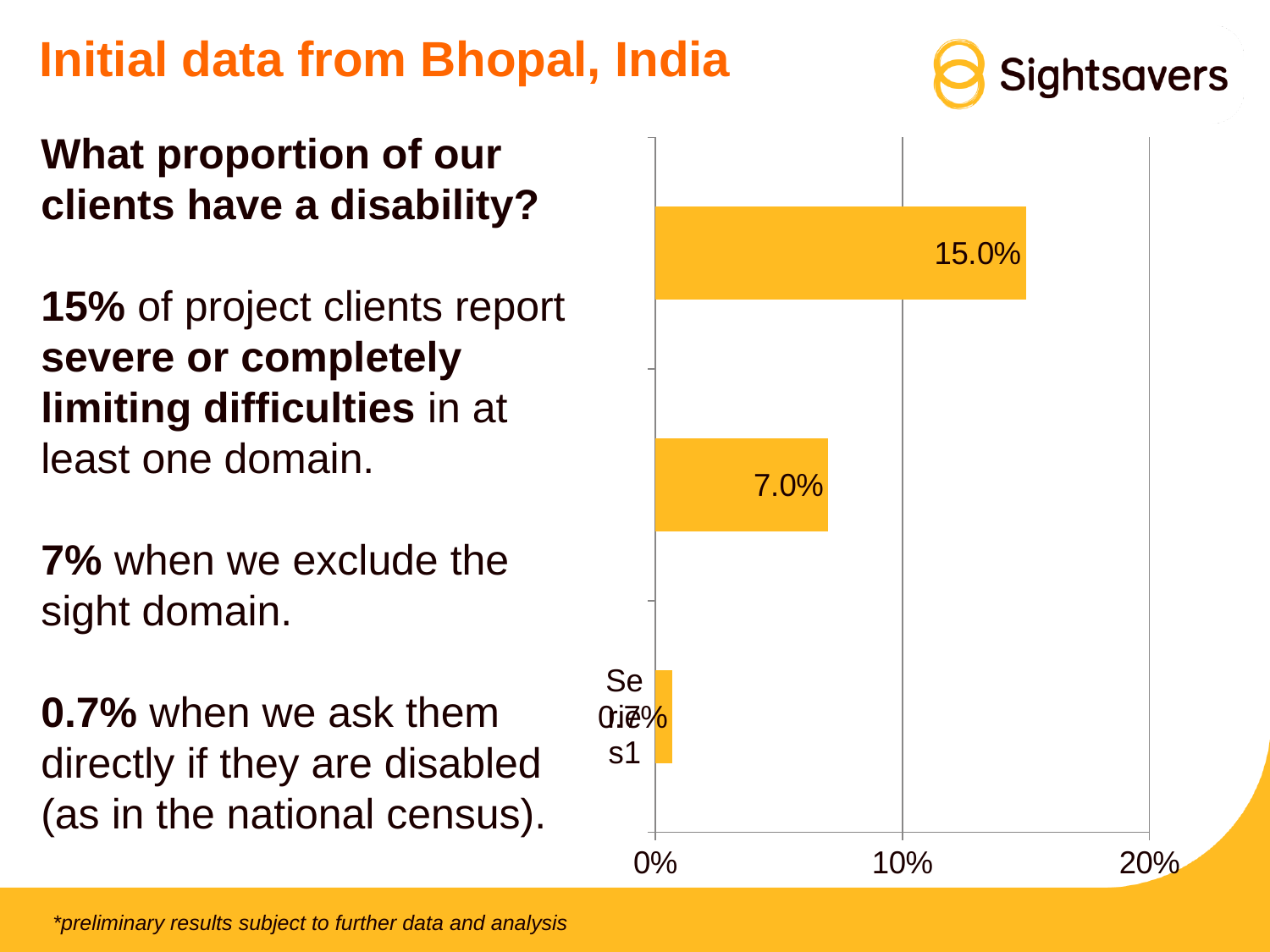
Which is larger, the value of the top bar or the value of the middle bar? the top bar Which bar has the lowest value in the chart? the bottom bar (0.7%) Is the value of the top bar greater or less than 10%? greater What is the value shown on the top bar of the chart? 15.0% What is the value shown on the bottom bar of the chart? 0.7% What is the maximum value shown on the chart's horizontal axis? 20% What is the difference between the top bar's value and the middle bar's value? 8.0% How many bars are plotted in the chart? 3 Which bar has the highest value in the chart? the top bar (15.0%) What kind of chart is shown on the slide? bar chart What is the value shown on the middle bar of the chart? 7.0% What is the difference between the middle bar's value and the bottom bar's value? 6.3%